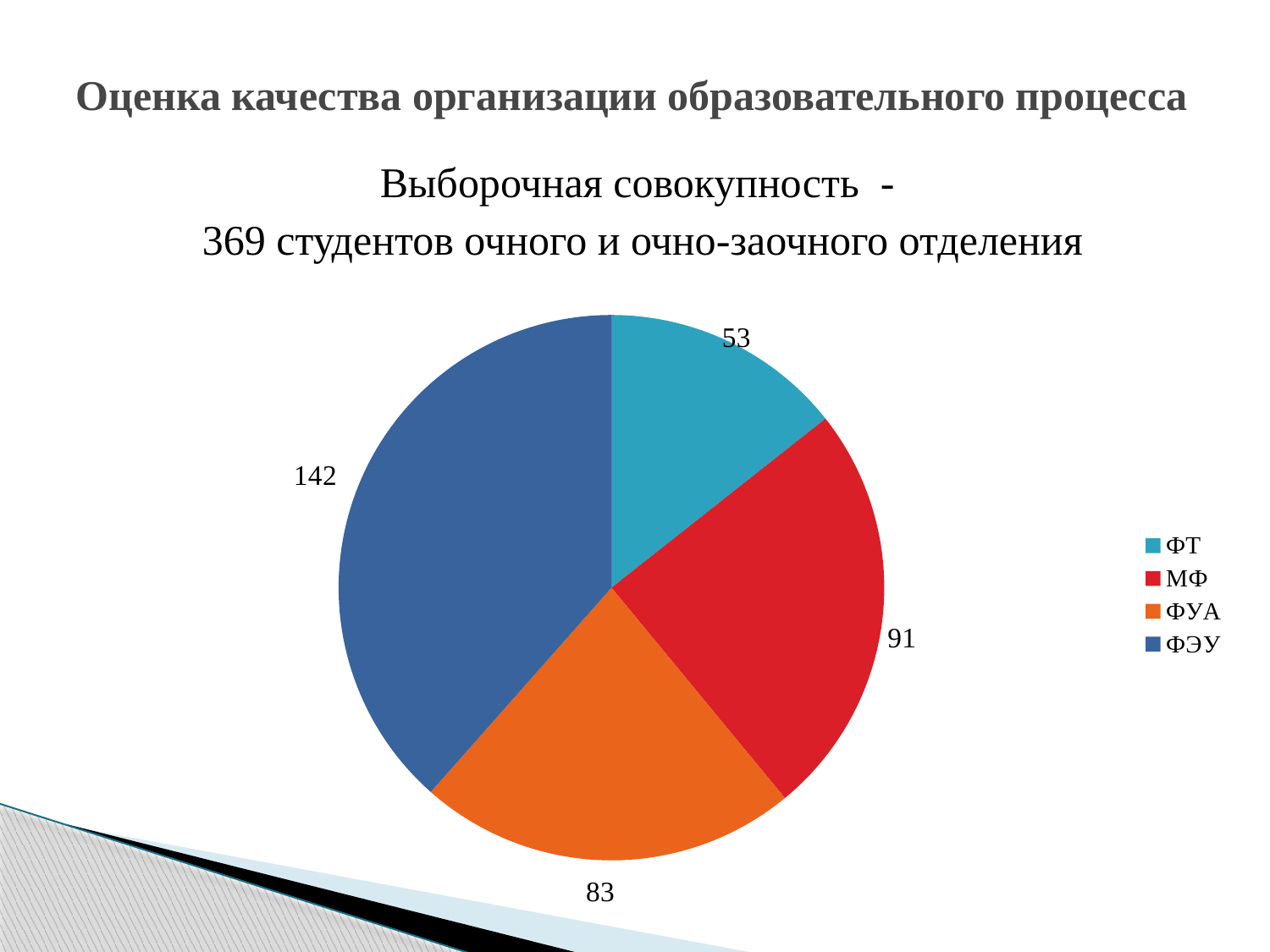
What is the value for ФУА? 83 What is the difference between the values for ФЭУ and ФТ? 89 Which faculty has the smallest slice of the pie? ФТ Which faculty has the largest slice of the pie? ФЭУ How many students are in the ФЭУ slice? 142 What kind of chart is shown on the slide? pie chart What is the value for ФТ? 53 What is the value for МФ? 91 How many slices does the pie chart have? 4 What is the total of all slices in the pie chart? 369 Which is larger, the value for МФ or the value for ФУА? МФ What colour is the ФУА slice? orange